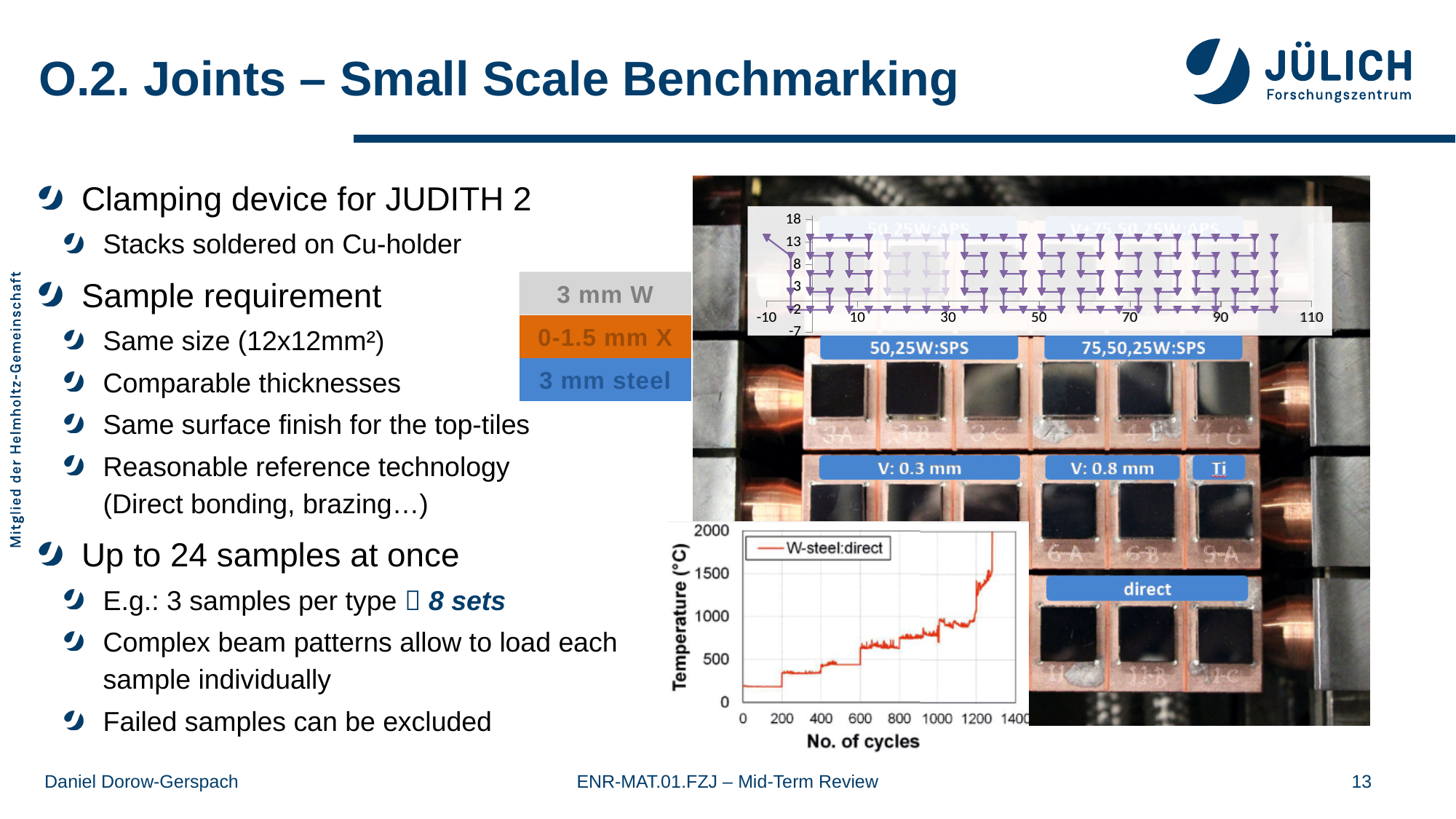
In the bottom chart (Temperature vs No. of cycles), is the temperature at 1000 cycles greater or less than 500? greater In the bottom chart (Temperature vs No. of cycles), is the temperature at 800 cycles greater or less than 1000? less In the bottom chart (Temperature vs No. of cycles), does the temperature rise or fall as the number of cycles increases? rise In the bottom chart (Temperature vs No. of cycles), what is the highest tick value shown on the y axis? 2000 What kind of chart is the bottom chart with the 'No. of cycles' axis? line chart In the bottom chart (Temperature vs No. of cycles), is the temperature at 100 cycles greater or less than 500? less In the top chart overlaid on the photo (purple markers), what is the highest tick value shown on the y axis? 18 In the bottom chart (Temperature vs No. of cycles), what is the name of the series in the legend? W-steel:direct In the bottom chart (Temperature vs No. of cycles), how many series does the legend list? 1